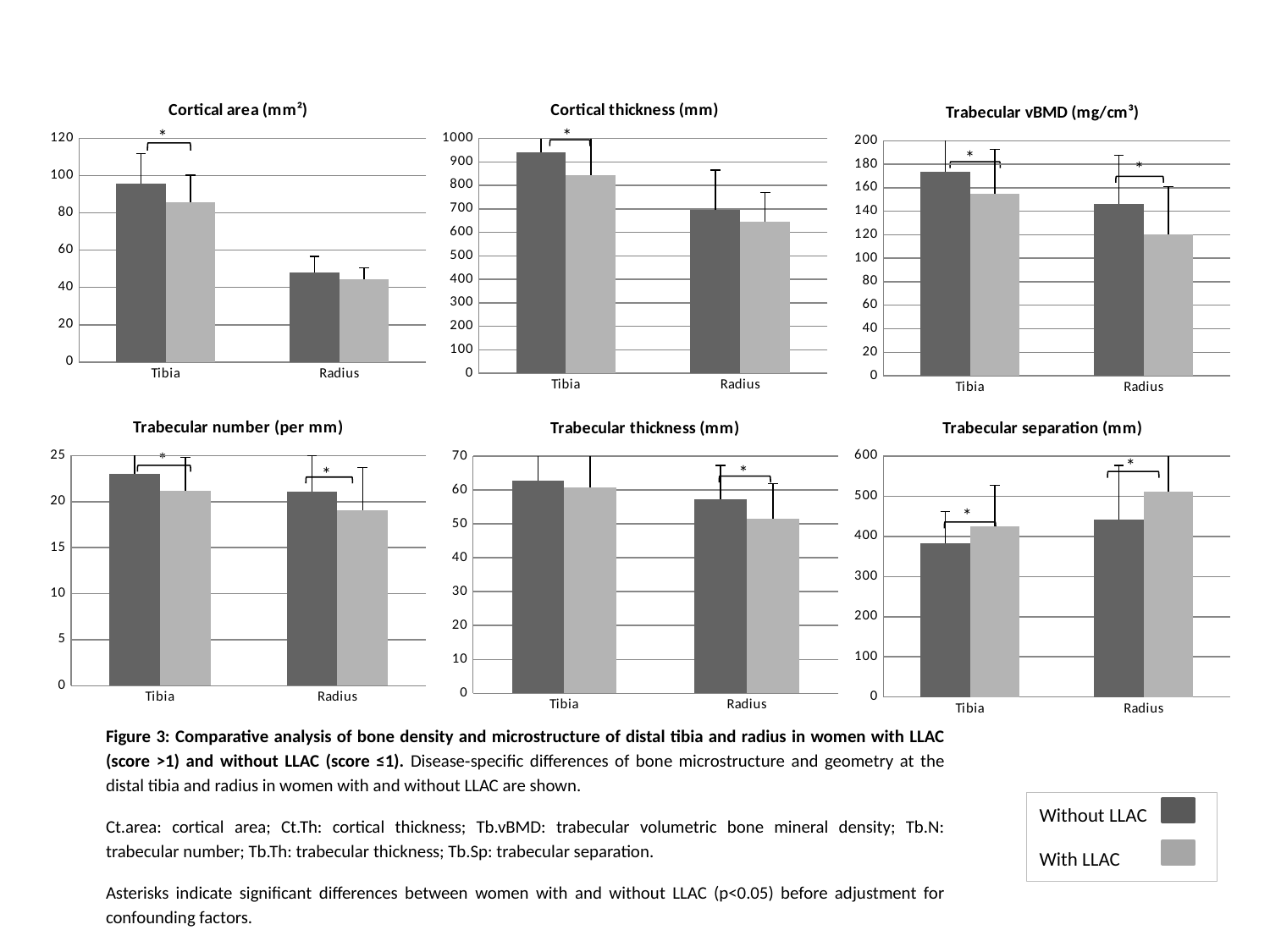
What kind of chart is the 'Cortical area (mm²)' chart? bar chart In the 'Cortical thickness (mm)' chart, is the value for Radius With LLAC greater or less than 700? less In the 'Trabecular vBMD (mg/cm³)' chart, is the value for Tibia Without LLAC greater or less than 160? greater In the 'Cortical area (mm²)' chart, which bar is the lowest? Radius With LLAC How many categories are shown on the x axis of the 'Cortical thickness (mm)' chart? 2 How many series does the legend on the slide list? 2 In the 'Trabecular separation (mm)' chart, which bar is the highest? Radius With LLAC In the 'Trabecular thickness (mm)' chart, is the value for Radius With LLAC greater or less than 60? less In the 'Trabecular vBMD (mg/cm³)' chart, which is larger for Radius: Without LLAC or With LLAC? Without LLAC In the 'Trabecular separation (mm)' chart, which is larger for Tibia: Without LLAC or With LLAC? With LLAC